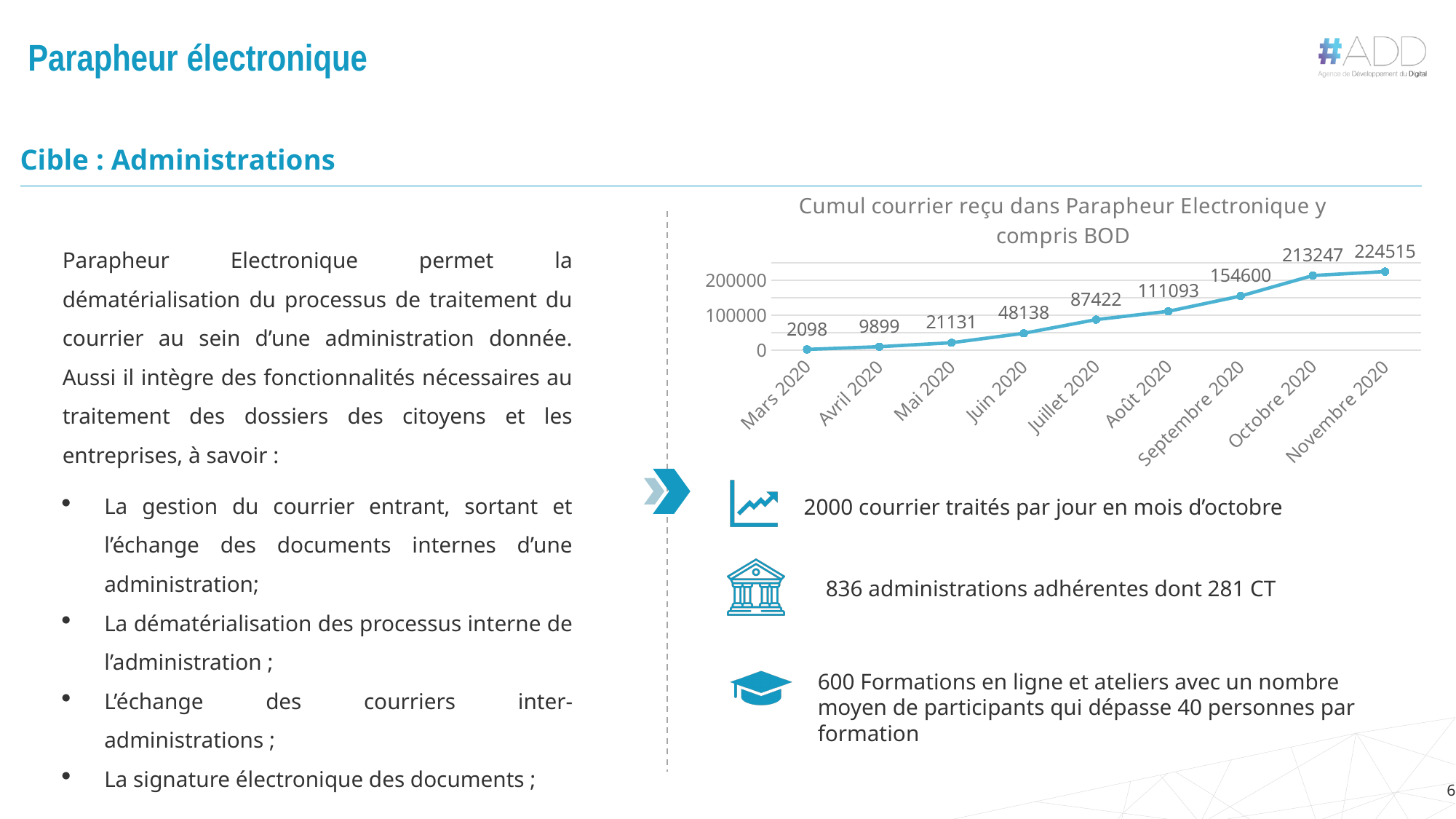
What is the difference between the values for Octobre 2020 and Septembre 2020? 58647 Which month has the highest value? Novembre 2020 What is the value for Juin 2020? 48138 Which month has the lowest value? Mars 2020 Do the values rise or fall from Mars 2020 to Novembre 2020? rise What is the value for Novembre 2020? 224515 What is the title of the chart? Cumul courrier reçu dans Parapheur Electronique y compris BOD Which is larger, the value for Juillet 2020 or the value for Août 2020? Août 2020 What is the value for Mars 2020? 2098 Is the value for Septembre 2020 greater or less than 100000? greater What kind of chart is shown on the slide? line chart How many months are plotted on the chart? 9